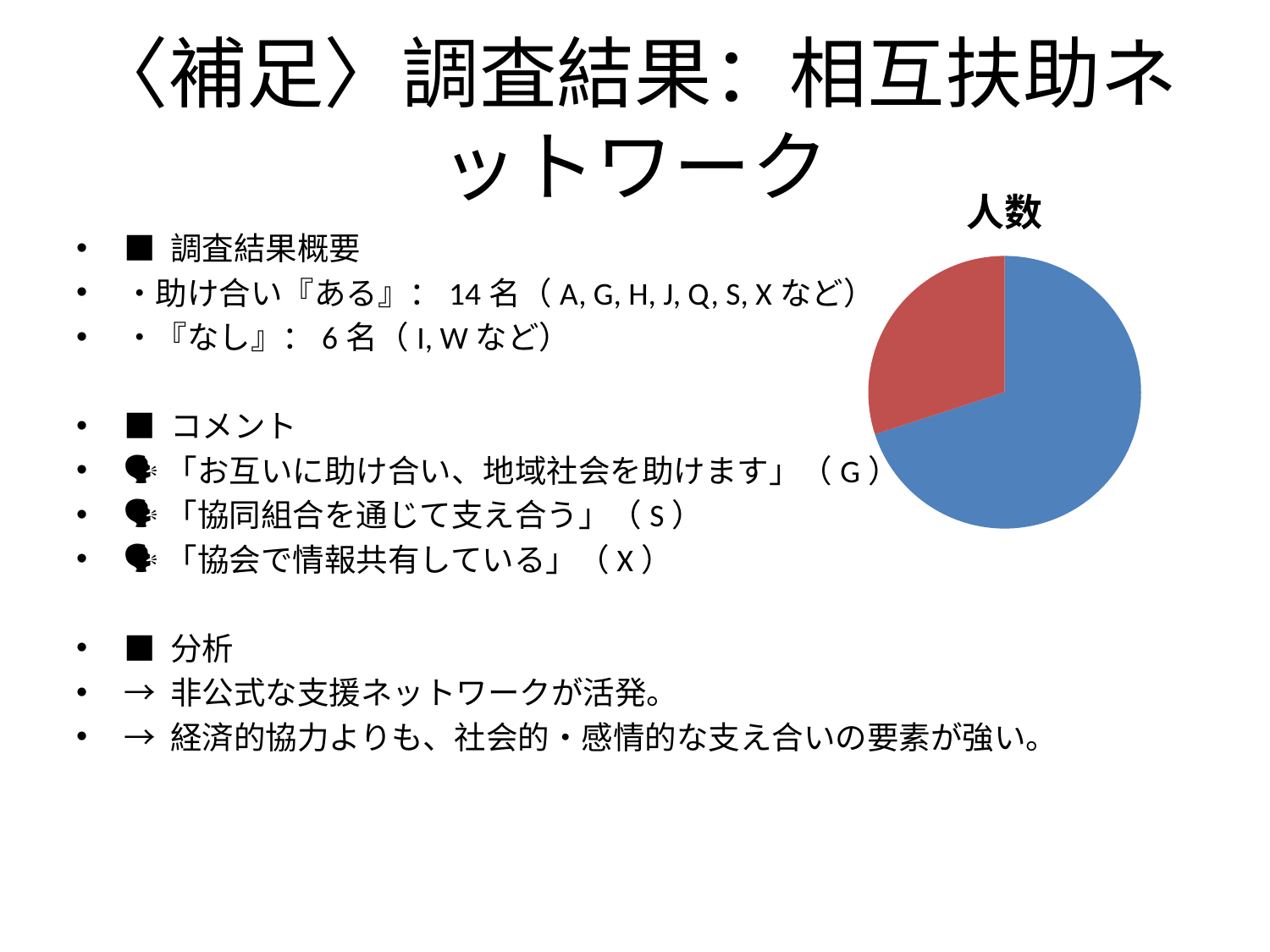
How many slices does the pie chart have? 2 Does the blue slice cover more or less than half of the pie chart? more Which colour slice takes up the smallest share of the pie chart? red What kind of chart is shown on the slide? pie chart Which colour slice takes up the largest share of the pie chart? blue Does the pie chart display a legend? No Which slice of the pie chart is larger, the blue one or the red one? blue Does the red slice cover more or less than half of the pie chart? less What is the title of the pie chart? 人数